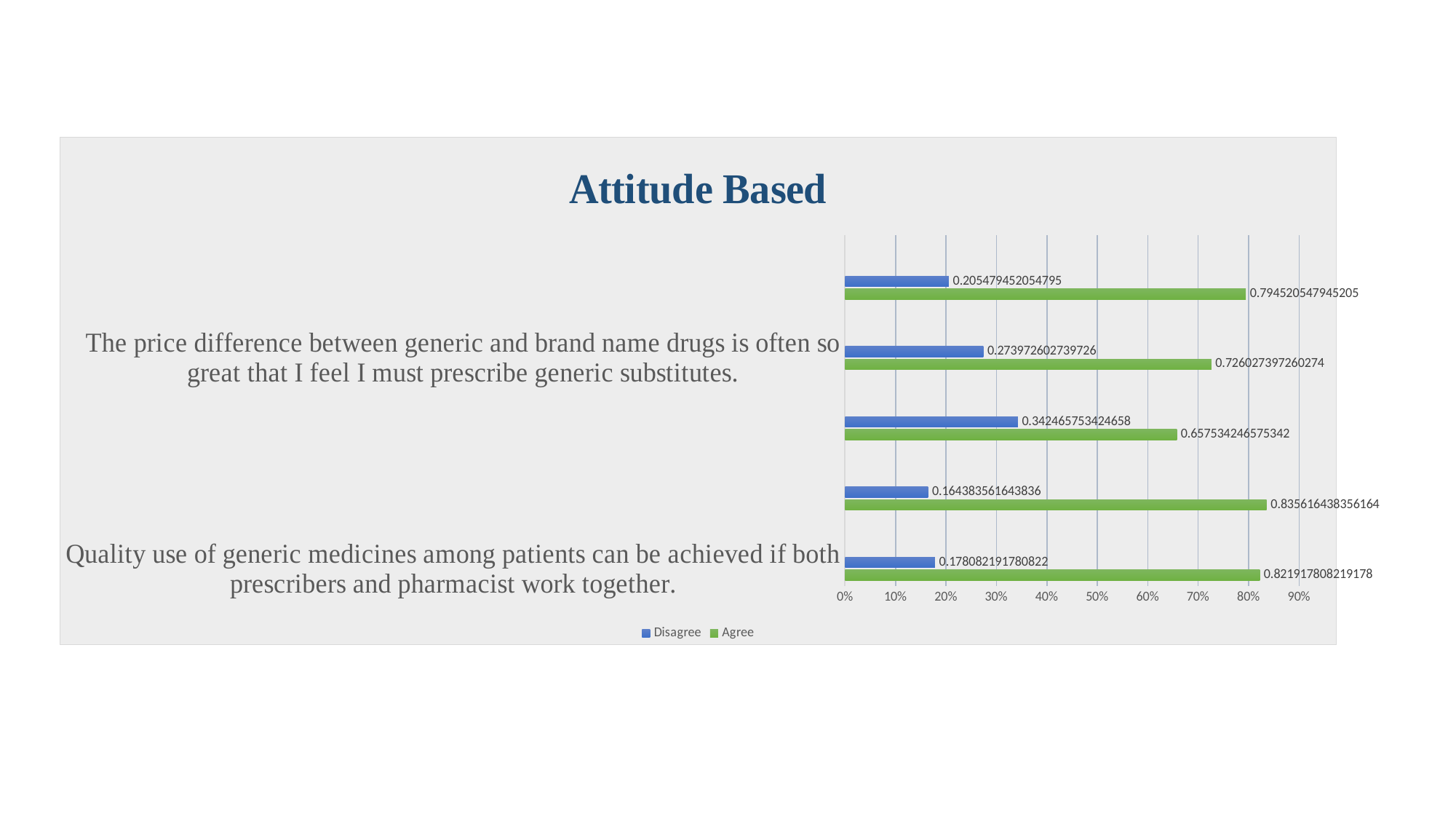
How many series does the legend list? 2 What is the lowest Disagree value shown in the chart? 0.164383561643836 What is the Agree value for "Quality use of generic medicines among patients can be achieved if both prescribers and pharmacist work together."? 0.821917808219178 What type of chart is shown on the slide? bar chart What is the Disagree value for the topmost pair of bars in the chart? 0.205479452054795 For "The price difference between generic and brand name drugs..." statement, which is larger, Agree or Disagree? Agree What is the Disagree value for "Quality use of generic medicines among patients can be achieved if both prescribers and pharmacist work together."? 0.178082191780822 What is the Agree value for "The price difference between generic and brand name drugs is often so great that I feel I must prescribe generic substitutes."? 0.726027397260274 What is the Disagree value for "The price difference between generic and brand name drugs is often so great that I feel I must prescribe generic substitutes."? 0.273972602739726 What is the title of the chart? Attitude Based How many pairs of bars (categories) are plotted in the chart? 5 What is the highest Agree value shown in the chart? 0.835616438356164